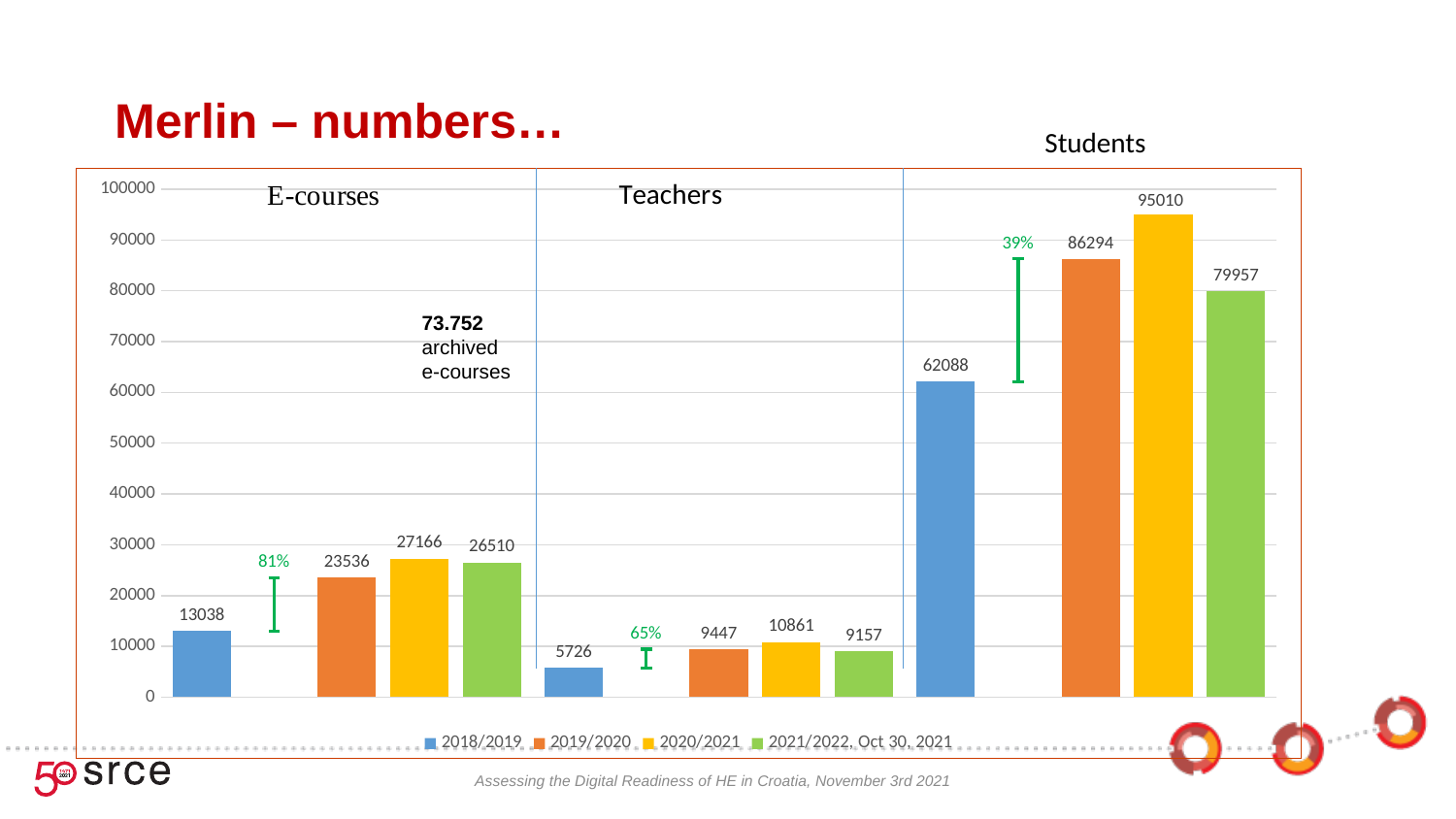
What percentage increase is annotated between the 2018/2019 and 2019/2020 Students bars? 39% Which academic year has the highest number of Students? 2020/2021 What is the number of Teachers for 2021/2022, Oct 30, 2021? 9157 What is the difference between the number of Students in 2020/2021 and in 2021/2022, Oct 30, 2021? 15053 Is the number of Students for 2018/2019 greater or less than 60000? greater Which is larger: the number of Teachers in 2019/2020 or in 2021/2022, Oct 30, 2021? 2019/2020 What kind of chart is shown on the slide? Bar chart What is the number of E-courses for 2018/2019? 13038 What is the number of Students for 2020/2021? 95010 What is the difference between the number of E-courses in 2019/2020 and in 2018/2019? 10498 How many series does the legend list? 4 Which academic year has the lowest number of Teachers? 2018/2019